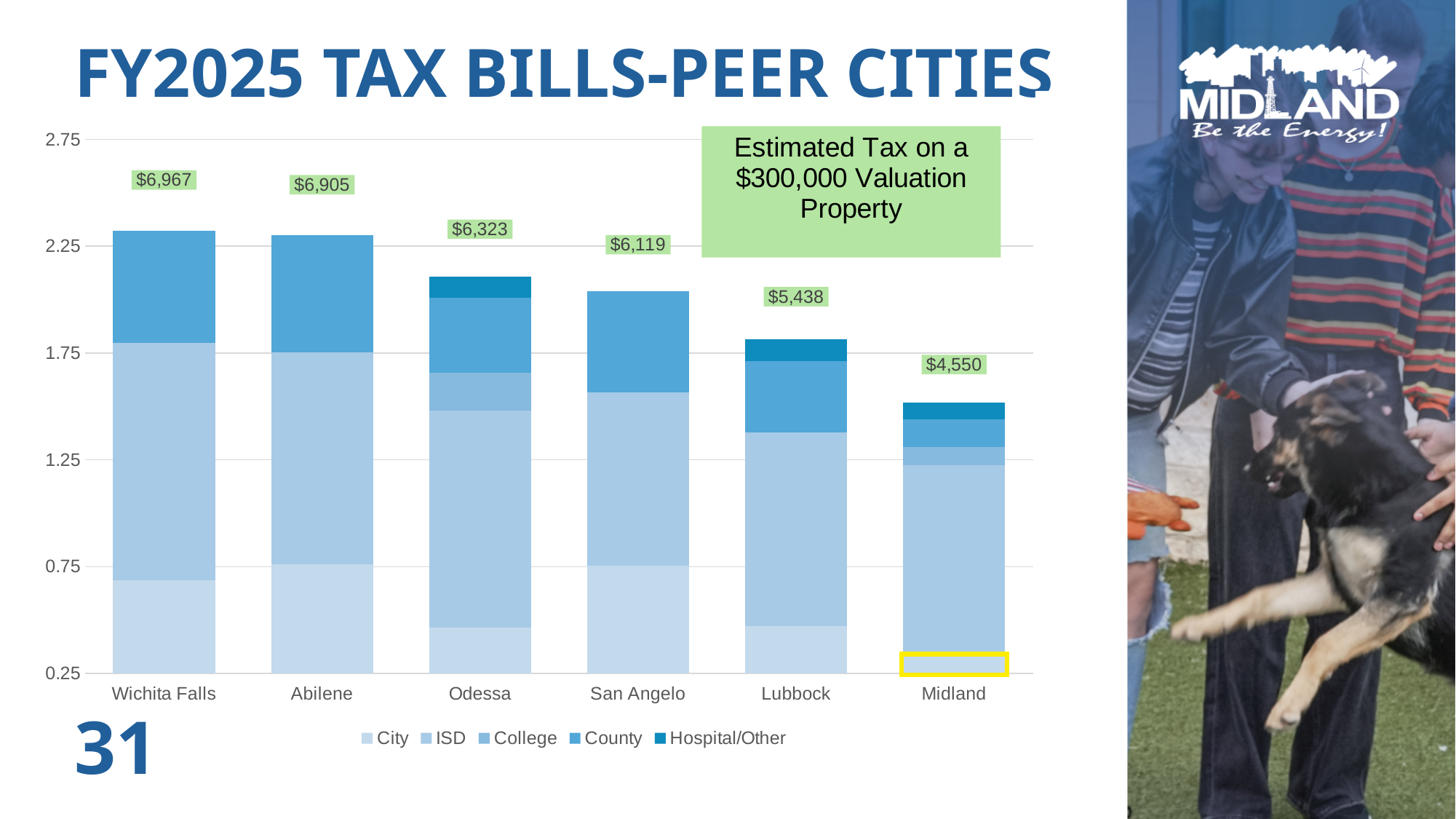
What is the estimated tax label shown above the Midland bar? $4,550 What is the estimated tax label shown above the Wichita Falls bar? $6,967 How many cities are shown on the x axis? 6 What is the difference between the estimated tax labels for Wichita Falls and Midland? $2,417 What is the difference between the estimated tax labels for Lubbock and Midland? $888 Which has a larger estimated tax label, San Angelo or Lubbock? San Angelo What kind of chart is shown on the slide? Stacked bar chart How many series does the legend list? 5 Which city has the lowest estimated tax bill? Midland What is the estimated tax label shown above the Odessa bar? $6,323 Is the total height of the Wichita Falls bar greater or less than 2.25? greater Which city has the highest estimated tax bill? Wichita Falls